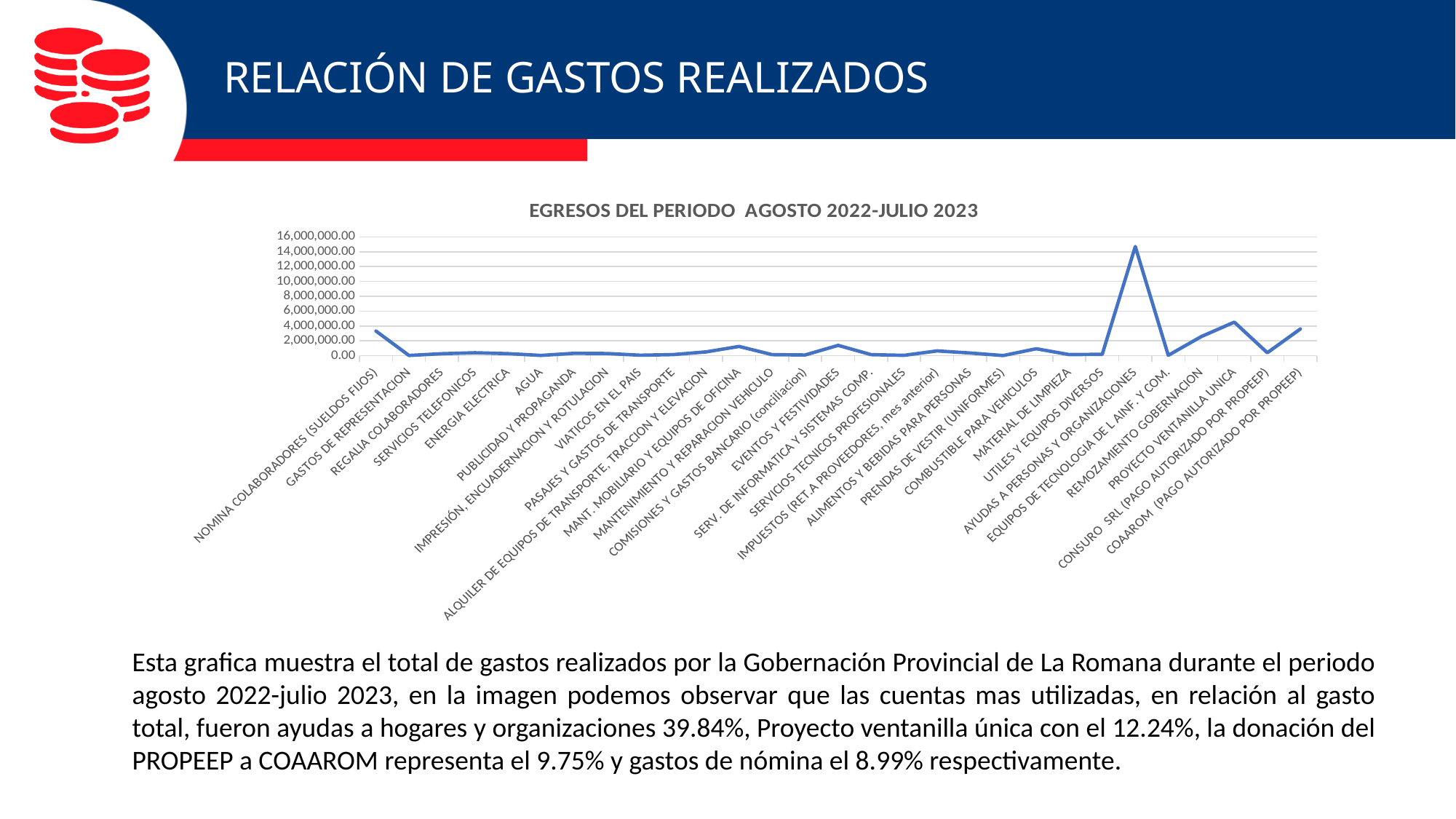
Is the value for COAAROM (PAGO AUTORIZADO POR PROPEEP) greater or less than 2,000,000.00? greater Is the value for PROYECTO VENTANILLA UNICA greater or less than 2,000,000.00? greater Is the value for NOMINA COLABORADORES (SUELDOS FIJOS) greater or less than 6,000,000.00? less What is the highest value shown on the y axis of the chart? 16,000,000.00 What type of chart is shown on the slide? Line chart Which category has the highest value in the chart? AYUDAS A PERSONAS Y ORGANIZACIONES How many expense categories are plotted along the x axis of the chart? 29 Which is larger, the value for AYUDAS A PERSONAS Y ORGANIZACIONES or the value for PROYECTO VENTANILLA UNICA? AYUDAS A PERSONAS Y ORGANIZACIONES What is the title of the chart? EGRESOS DEL PERIODO AGOSTO 2022-JULIO 2023 Which is larger, the value for NOMINA COLABORADORES (SUELDOS FIJOS) or the value for GASTOS DE REPRESENTACION? NOMINA COLABORADORES (SUELDOS FIJOS)